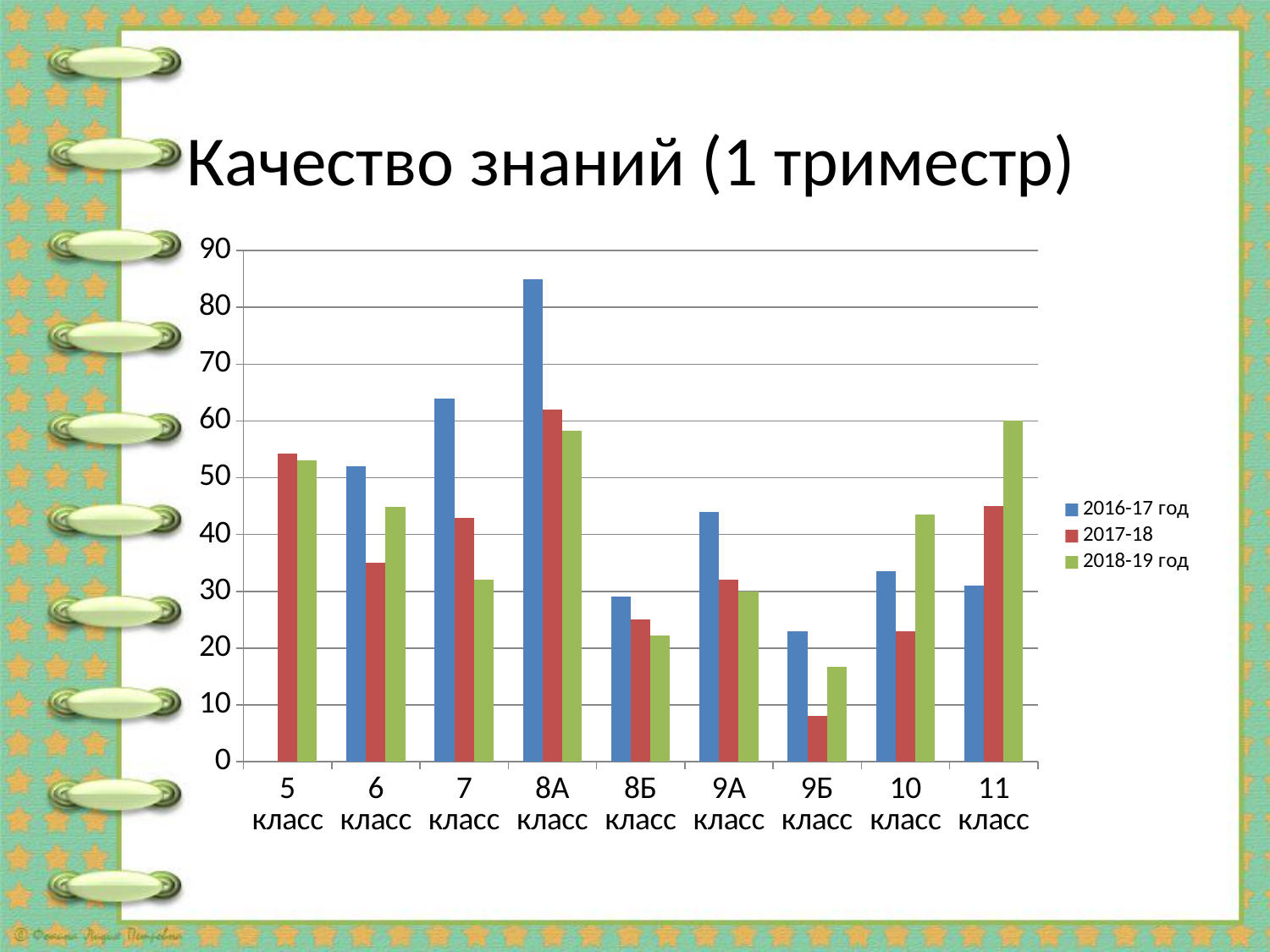
For 11 класс, which series has the larger value: 2016-17 год or 2018-19 год? 2018-19 год For 7 класс, which series has the larger value: 2016-17 год or 2018-19 год? 2016-17 год Which class has the highest value for 2016-17 год? 8А класс Is the value for 9Б класс in 2017-18 greater or less than 10? less How many series does the legend list? 3 What is the title of the chart? Качество знаний (1 триместр) Is the value for 7 класс in 2016-17 год greater or less than 60? greater What kind of chart is shown on the slide? bar chart Is the value for 8А класс in 2016-17 год greater or less than 80? greater Which class has the highest value for 2018-19 год? 11 класс Which class has the lowest value for 2017-18? 9Б класс How many classes are shown along the x axis? 9